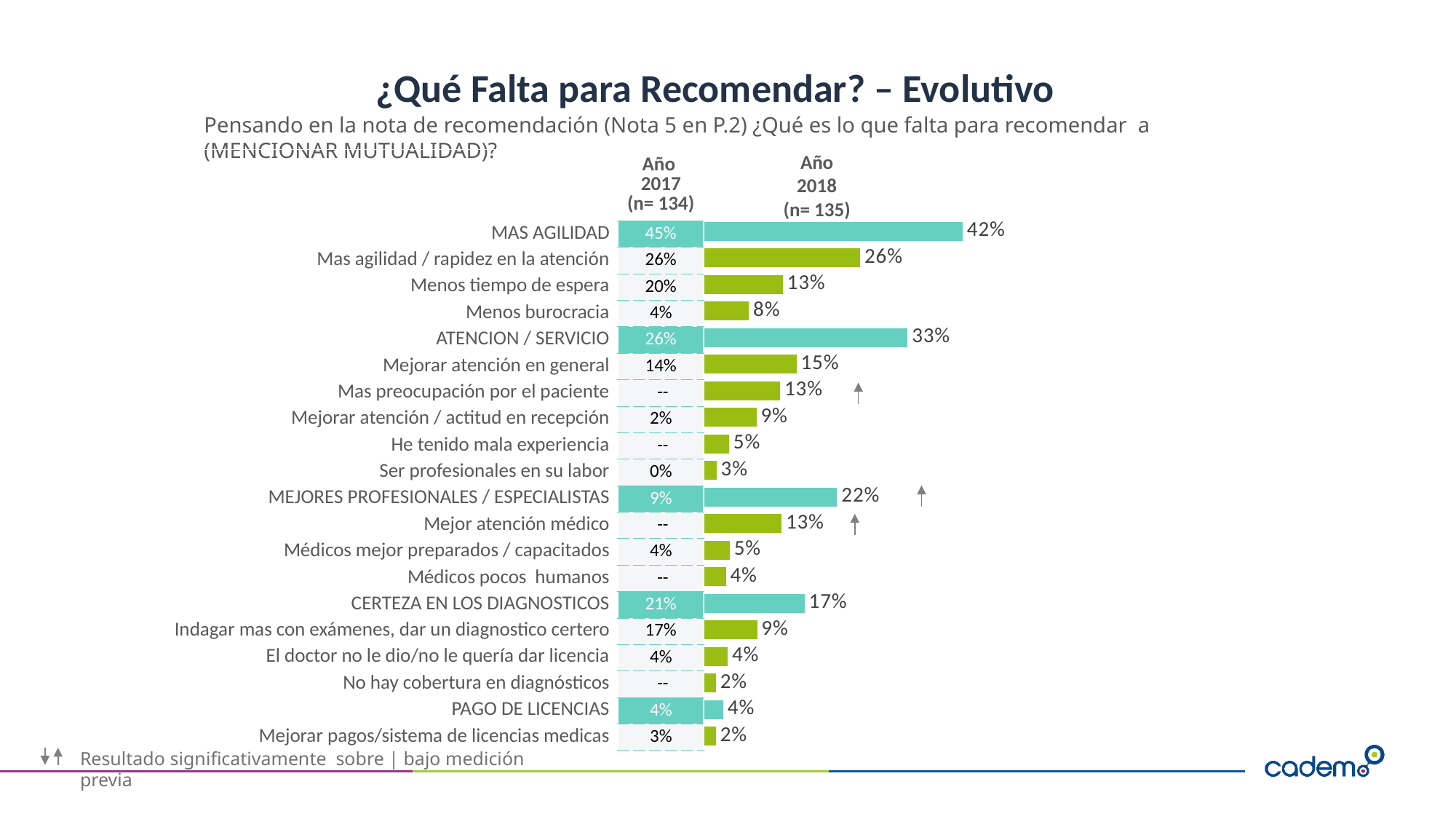
Among the uppercase main categories (MAS AGILIDAD, ATENCION / SERVICIO, MEJORES PROFESIONALES / ESPECIALISTAS, CERTEZA EN LOS DIAGNOSTICOS, PAGO DE LICENCIAS), which has the lowest Año 2018 value? PAGO DE LICENCIAS How many categories are listed in the chart? 20 What is the Año 2018 value for MEJORES PROFESIONALES / ESPECIALISTAS? 22% Which has the larger Año 2018 value, ATENCION / SERVICIO or CERTEZA EN LOS DIAGNOSTICOS? ATENCION / SERVICIO What kind of chart is used to show the Año 2018 values? Bar chart What is the Año 2018 value for Menos burocracia? 8% What is shown as the Año 2017 value for Mejorar atención médico? -- By how many percentage points did Menos tiempo de espera change from Año 2017 to Año 2018? 7 percentage points (20% to 13%) By how many percentage points did MAS AGILIDAD change from Año 2017 to Año 2018? 3 percentage points (45% to 42%) What is the Año 2018 value for MAS AGILIDAD? 42% What is the Año 2017 value for Menos tiempo de espera? 20% Which category has the highest Año 2018 bar? MAS AGILIDAD